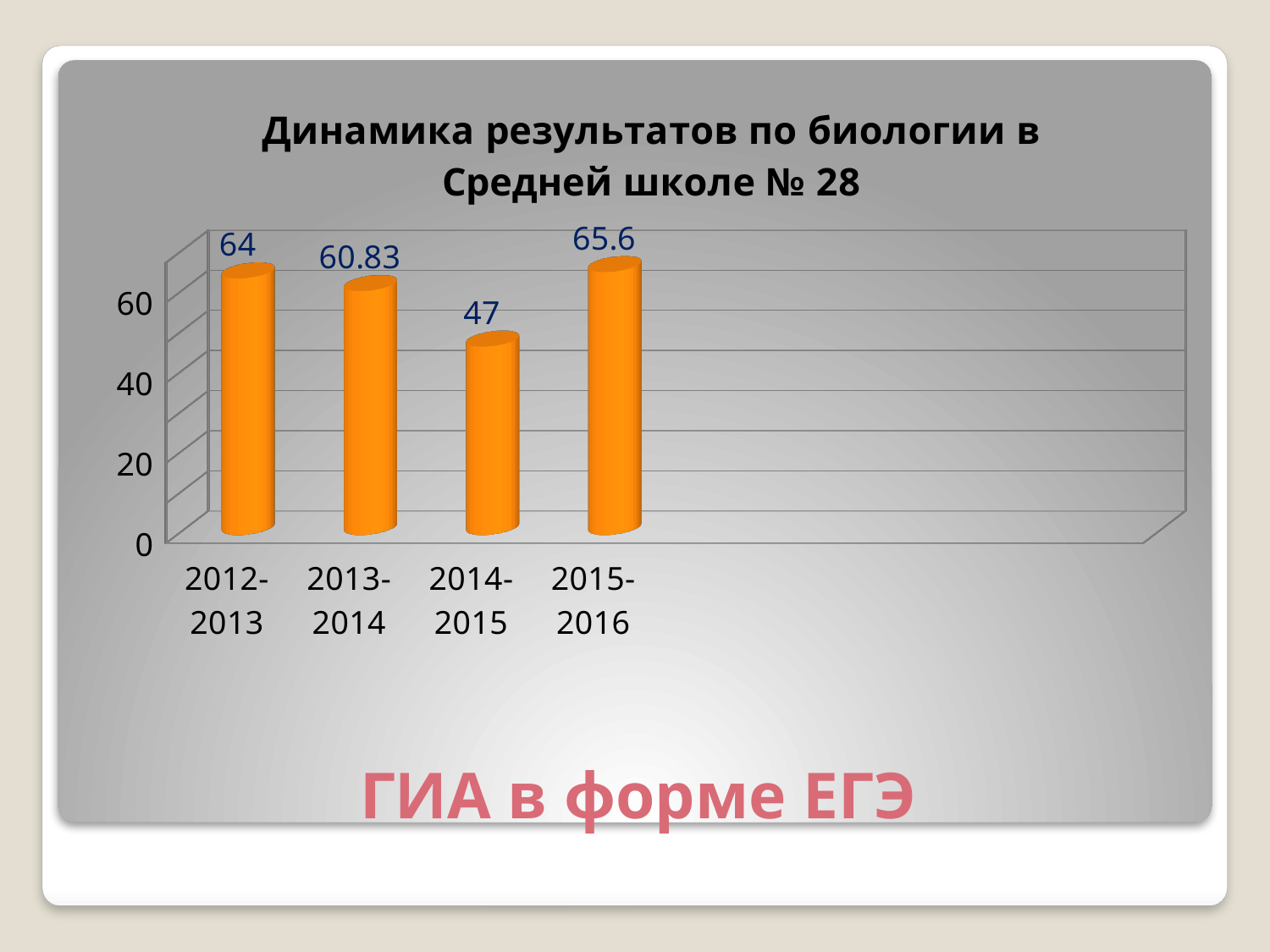
How many categories are shown on the x axis? 4 Which is larger, the value for 2012-2013 or the value for 2013-2014? 2012-2013 What is the title of the chart? Динамика результатов по биологии в Средней школе № 28 Which year has the highest value? 2015-2016 What is the value for 2015-2016? 65.6 What is the difference between the values for 2012-2013 and 2013-2014? 3.17 What is the value for 2012-2013? 64 What is the difference between the values for 2015-2016 and 2014-2015? 18.6 Which year has the lowest value? 2014-2015 What is the value for 2014-2015? 47 What kind of chart is shown on the slide? bar chart What is the value for 2013-2014? 60.83